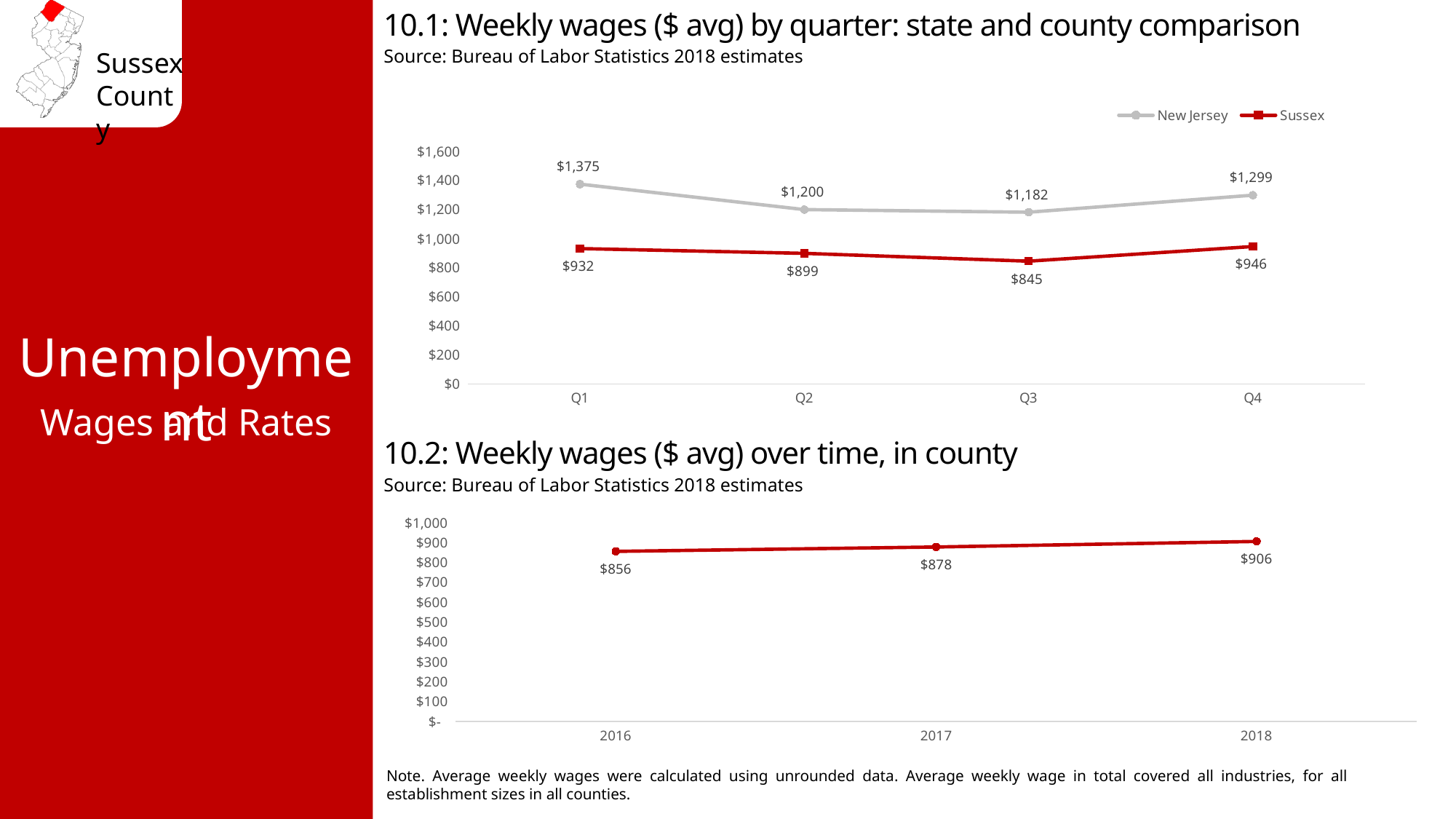
In chart 10.2, how many years are plotted? 3 In chart 10.2, what was the average weekly wage in 2017? $878 What kind of chart is chart 10.2? Line chart In chart 10.2, do the average weekly wages rise or fall from 2016 to 2018? Rise In chart 10.1, which quarter had the highest average weekly wage for Sussex? Q4 In chart 10.1, what was the average weekly wage for New Jersey in Q1? $1,375 In chart 10.1, which quarter had the lowest average weekly wage for New Jersey? Q3 In chart 10.1, which series is shown in red? Sussex In chart 10.2, what is the difference between the 2018 and 2016 average weekly wages? $50 In chart 10.1, what is the difference between the New Jersey and Sussex average weekly wages in Q4? $353 In chart 10.1, what was the average weekly wage for Sussex in Q3? $845 In chart 10.1, how many series does the legend list? 2